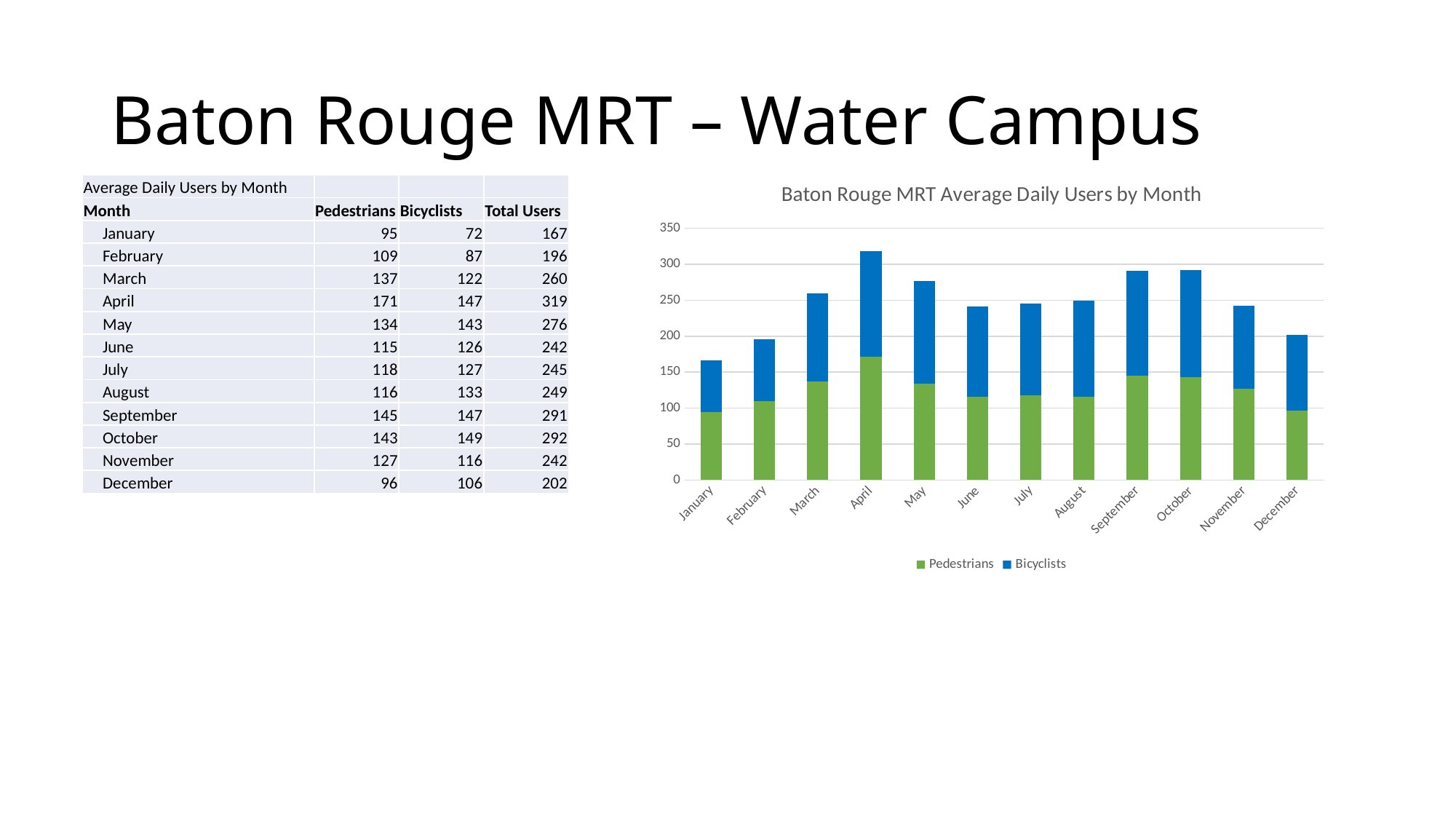
What is the Pedestrians value for April? 171 What is the difference between the Bicyclists values for April and January? 75 Which colour represents Bicyclists in the chart? blue Which month has the highest total bar in the chart? April What is the total of the stacked bar for September? 291 How many series does the chart legend list? 2 Which month has the lowest total bar in the chart? January What kind of chart is shown on the slide? stacked bar chart Which is larger, the Pedestrians value for March or the Pedestrians value for June? March How many months are plotted along the x axis of the chart? 12 Is the total bar for December greater or less than 250? less What is the Bicyclists value for October? 149